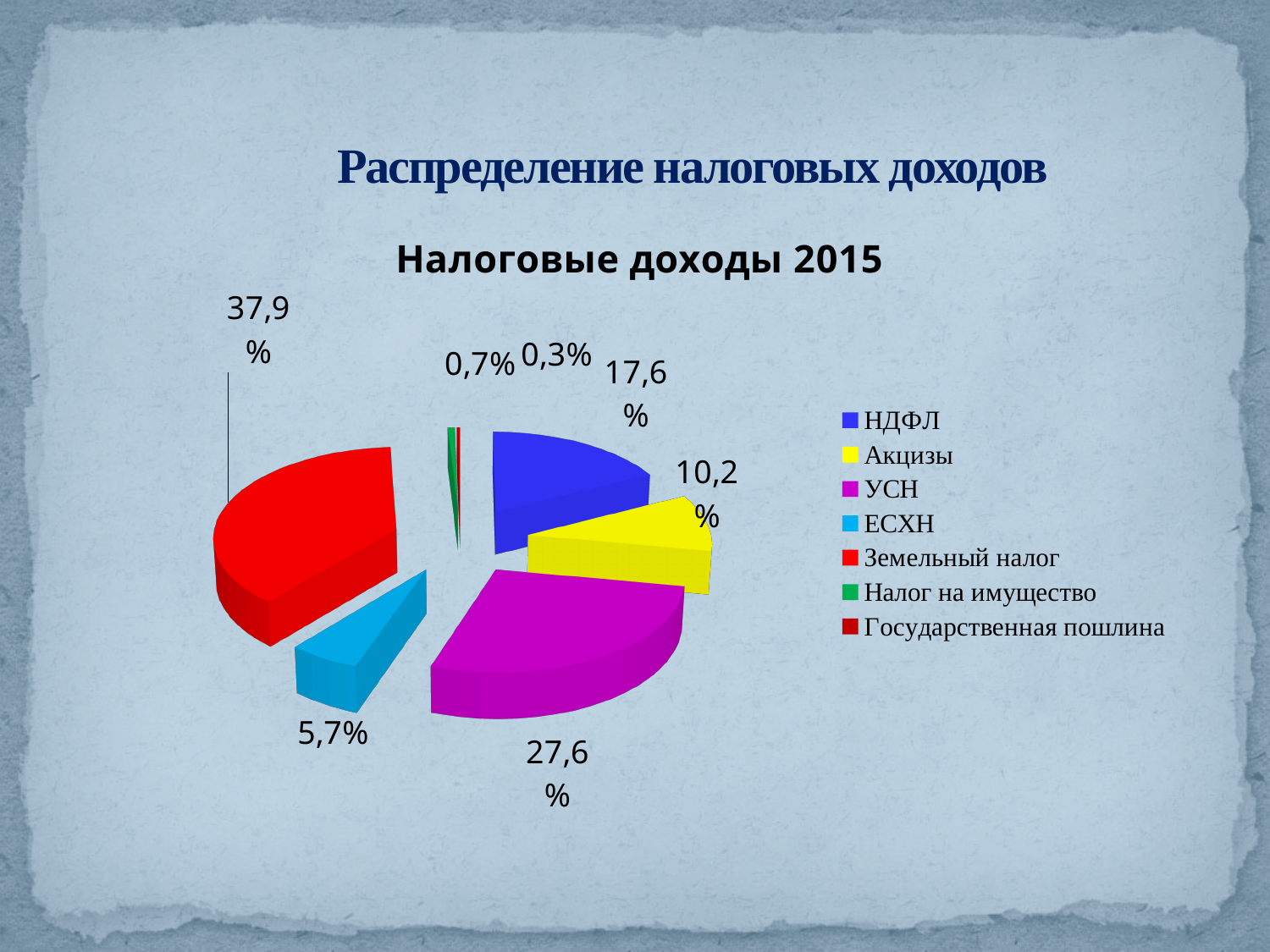
What share of tax revenue does Земельный налог account for? 37,9% What is the chart's title? Налоговые доходы 2015 What is the difference between the shares of Земельный налог and УСН? 10,3% What kind of chart is shown on the slide? pie chart What is the value for Акцизы? 10,2% How many categories does the legend list? 7 What is the value for УСН? 27,6% Which is larger, the share for УСН or the share for НДФЛ? УСН Which category has the smallest share of the pie? Государственная пошлина What is the value for НДФЛ? 17,6% Which category has the largest share of the pie? Земельный налог What is the value for ЕСХН? 5,7%